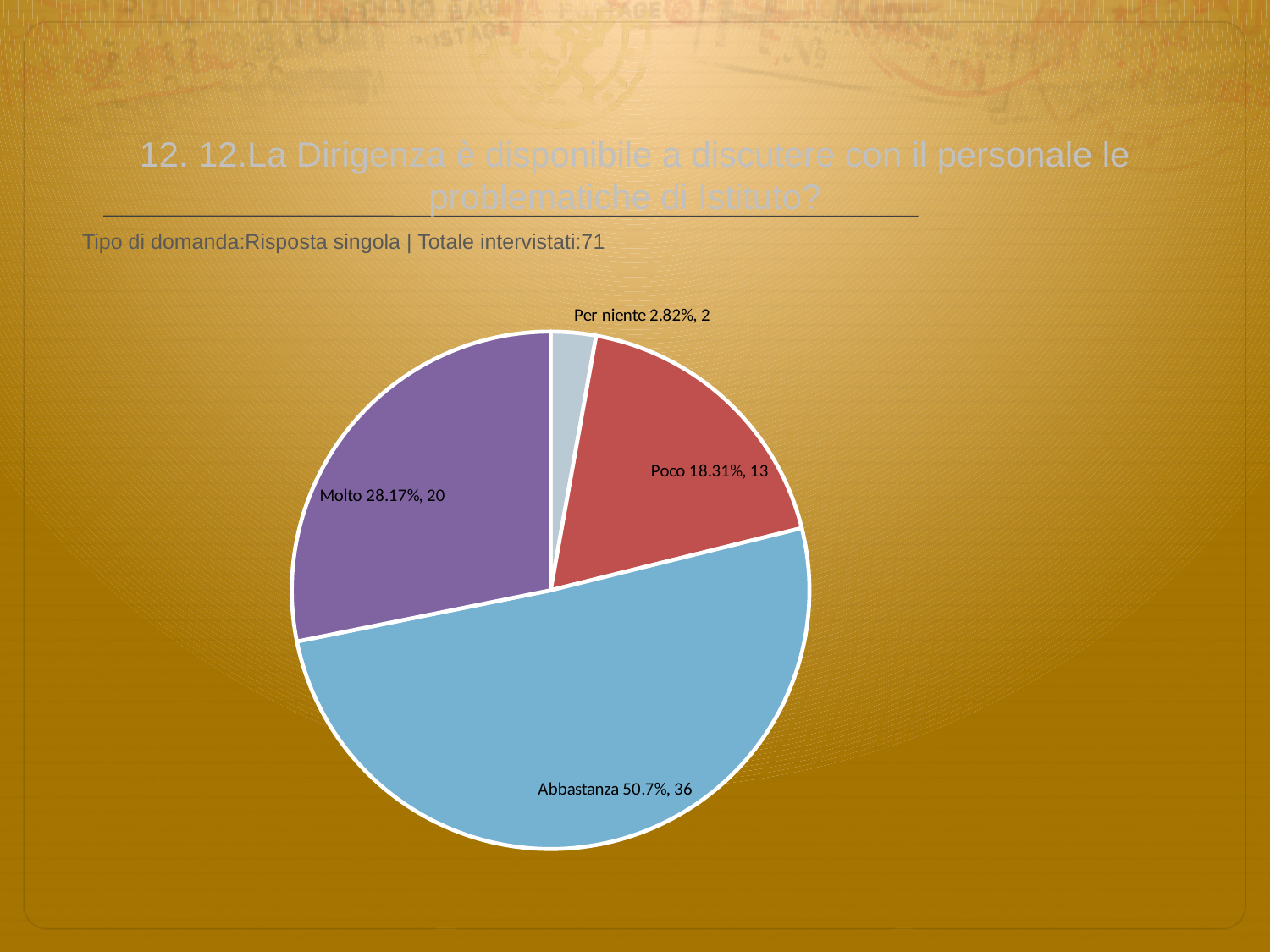
What percentage share does the Abbastanza slice have? 50.7% Which response category has the smallest slice? Per niente Which response category has the largest slice? Abbastanza What is the total number of respondents shown in the pie chart? 71 How many respondents answered Poco? 13 How many slices does the pie chart have? 4 How many respondents answered Molto? 20 Which has more respondents, Poco or Molto? Molto What percentage share does the Per niente slice have? 2.82% What is the difference in number of respondents between Abbastanza and Molto? 16 What kind of chart is shown on the slide? pie chart What colour is the Abbastanza slice? light blue